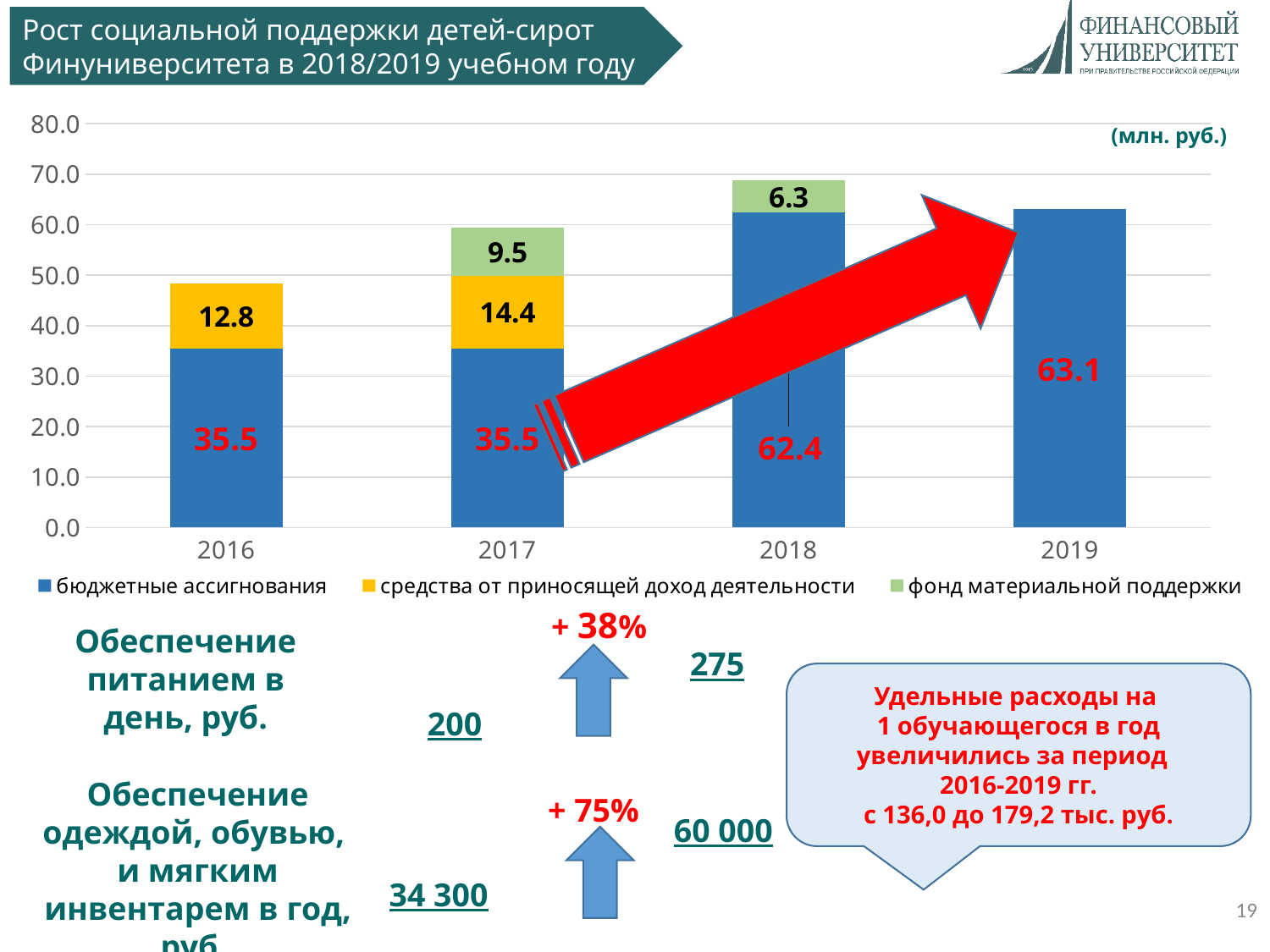
What is the total of the stacked bar for 2016? 48.3 What is the difference between бюджетные ассигнования in 2019 and in 2016? 27.6 What type of chart is shown on the slide? stacked bar chart What is the value of средства от приносящей доход деятельности in 2017? 14.4 What is the value of бюджетные ассигнования in 2018? 62.4 What is the total of the stacked bar for 2017? 59.4 How many series does the legend list? 3 How many years are shown on the x axis? 4 What unit is indicated in the top right corner of the chart? млн. руб. Which is larger: фонд материальной поддержки in 2017 or in 2018? 2017 What is the value of фонд материальной поддержки in 2018? 6.3 In which year is бюджетные ассигнования highest? 2019